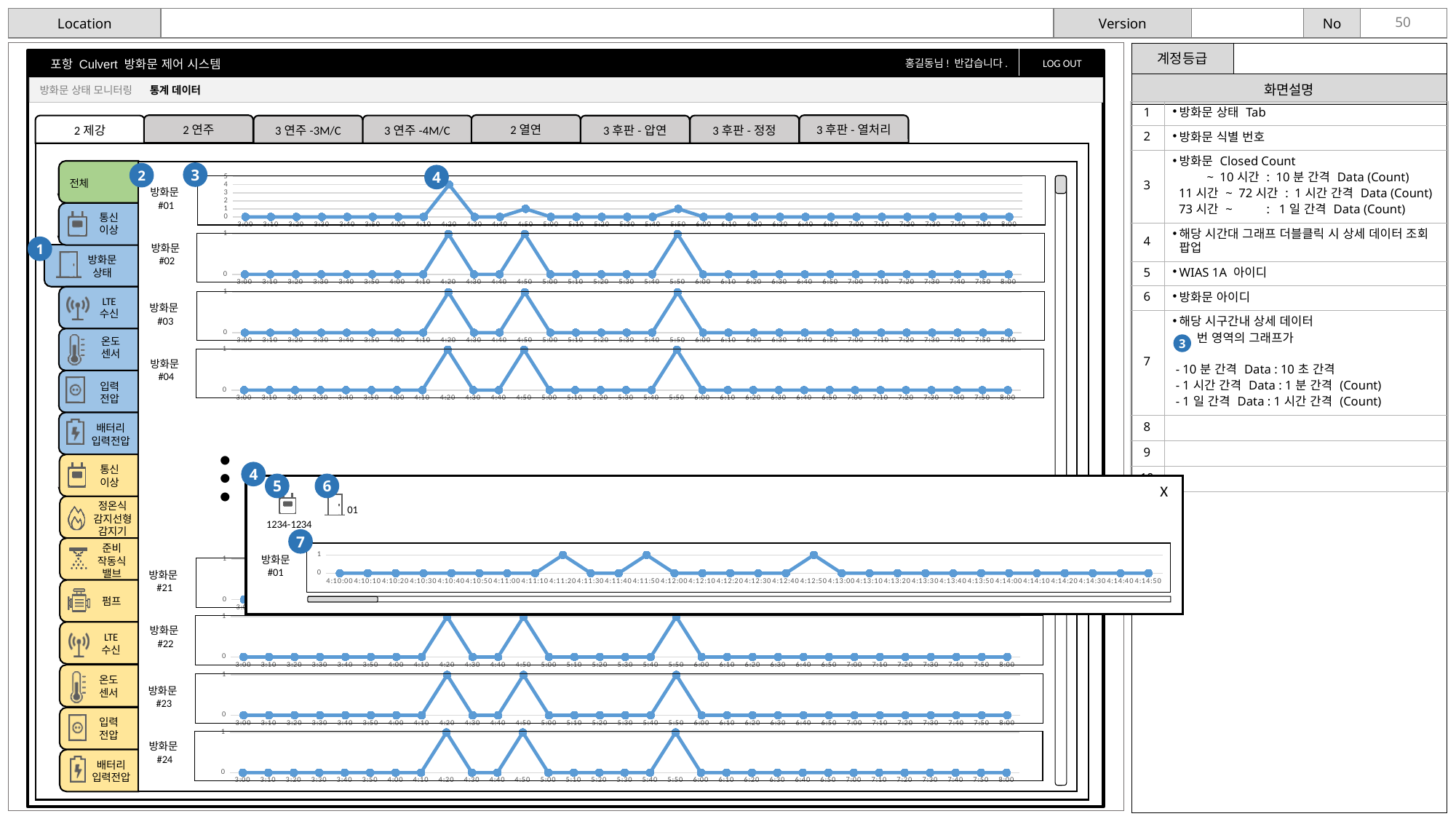
In the popup chart labelled 방화문 #01 (x axis 4:10:00 to 4:14:50), what is the value at 4:11:20? 1 In the 방화문 #01 chart at the top, which is larger, the value at 4:20 or the value at 4:50? 4:20 In the 방화문 #23 chart, what is the value at 5:50? 1 What is the first time label on the x axis of the popup chart labelled 방화문 #01? 4:10:00 How many time points are plotted on the x axis of the 방화문 #03 chart (3:00 to 8:00)? 31 In the popup chart labelled 방화문 #01, what is the value at 4:10:00? 0 In the 방화문 #02 chart, what is the value at 4:20? 1 In the 방화문 #01 chart at the top, at which time is the value highest? 4:20 In the 방화문 #24 chart, what is the difference between the value at 4:20 and the value at 4:30? 1 In the 방화문 #01 chart at the top, is the value at 4:20 greater or less than 3? greater In the 방화문 #02 chart, what is the value at 3:00? 0 What kind of chart is used for 방화문 #02? line chart